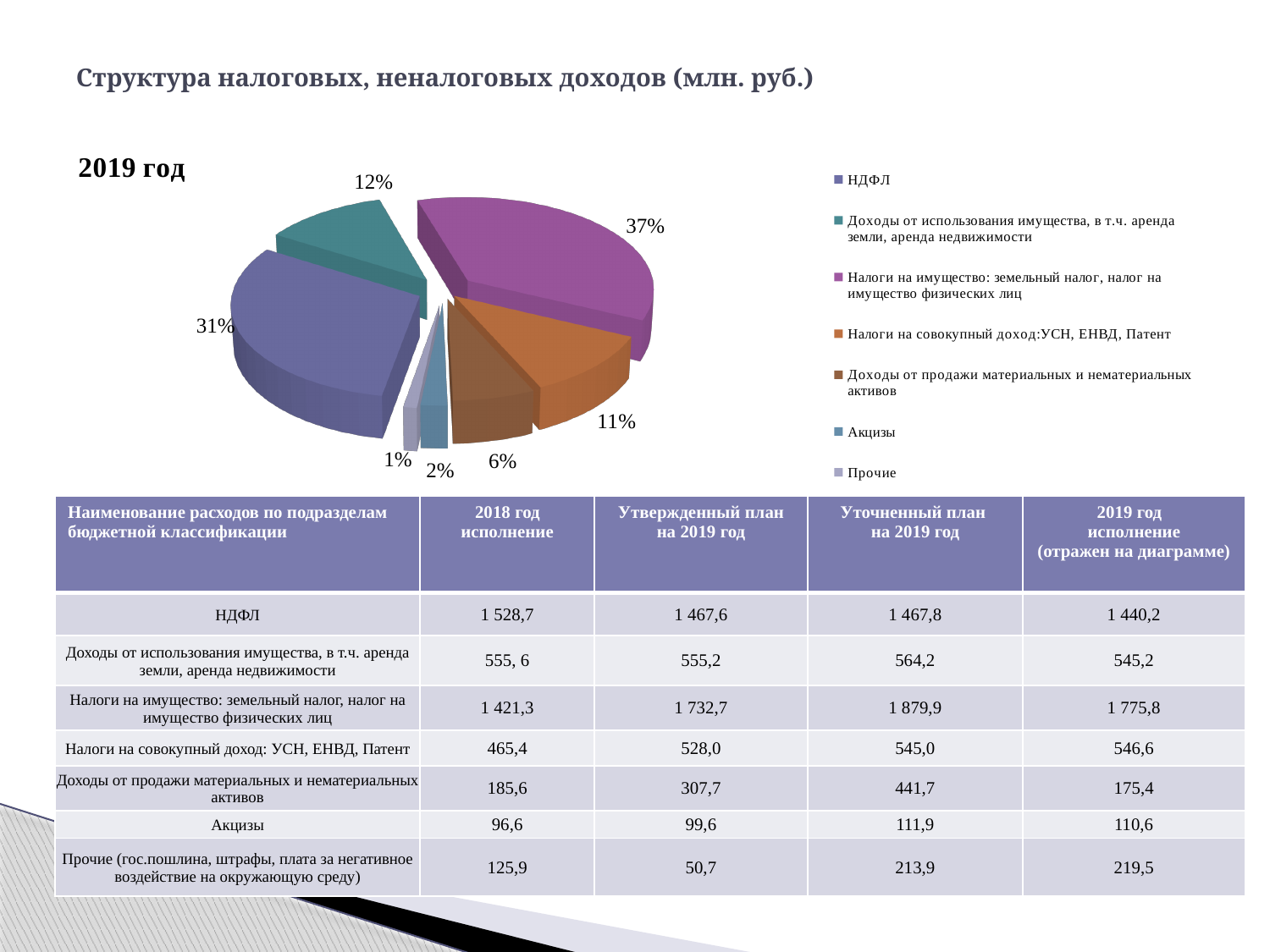
What share of the pie does the slice for НДФЛ have? 31% Which slice is larger: Доходы от продажи материальных и нематериальных активов or Налоги на совокупный доход: УСН, ЕНВД, Патент? Налоги на совокупный доход: УСН, ЕНВД, Патент How many slices does the pie chart have? 7 Which category has the smallest slice of the pie? Прочие What share of the pie does the slice for Акцизы have? 2% How many entries does the legend list? 7 Which category has the largest slice of the pie? Налоги на имущество: земельный налог, налог на имущество физических лиц What kind of chart is shown on the slide? Pie chart What is the difference in percentage points between the slice for Налоги на имущество and the slice for НДФЛ? 6 percentage points What share of the pie does the slice for Налоги на имущество: земельный налог, налог на имущество физических лиц have? 37%